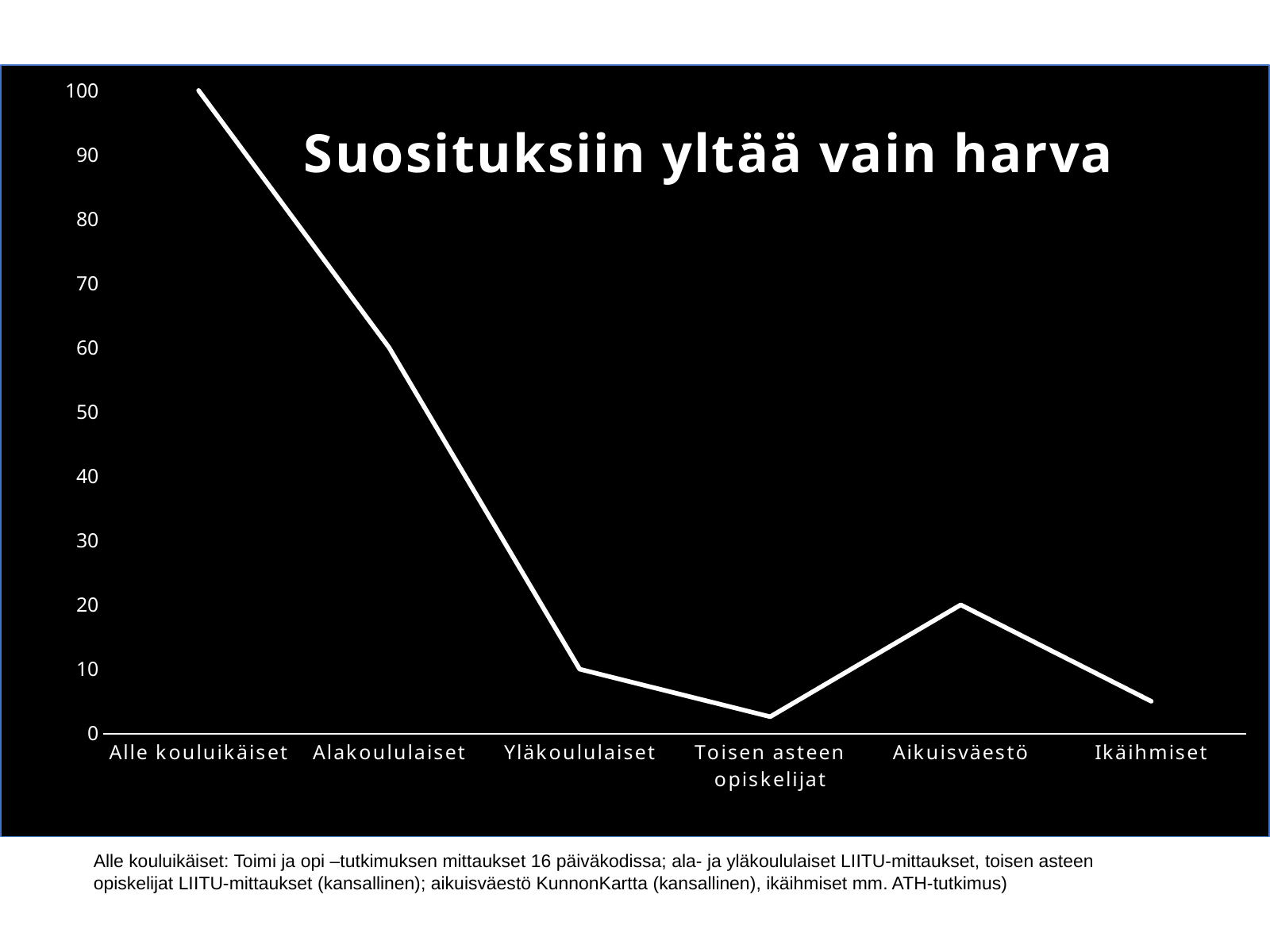
Is the value for Toisen asteen opiskelijat greater or less than 10? less Is the value for Ikäihmiset greater or less than 10? less What kind of chart is shown on the slide? line chart How many categories are shown on the x axis? 6 What is the value for Alle kouluikäiset? 100 What is the value for Aikuisväestö? 20 Which category has the highest value? Alle kouluikäiset Which is larger, the value for Aikuisväestö or the value for Ikäihmiset? Aikuisväestö What is the difference between the values for Alle kouluikäiset and Alakoululaiset? 40 What is the value for Yläkoululaiset? 10 What is the title of the chart? Suosituksiin yltää vain harva What is the value for Alakoululaiset? 60